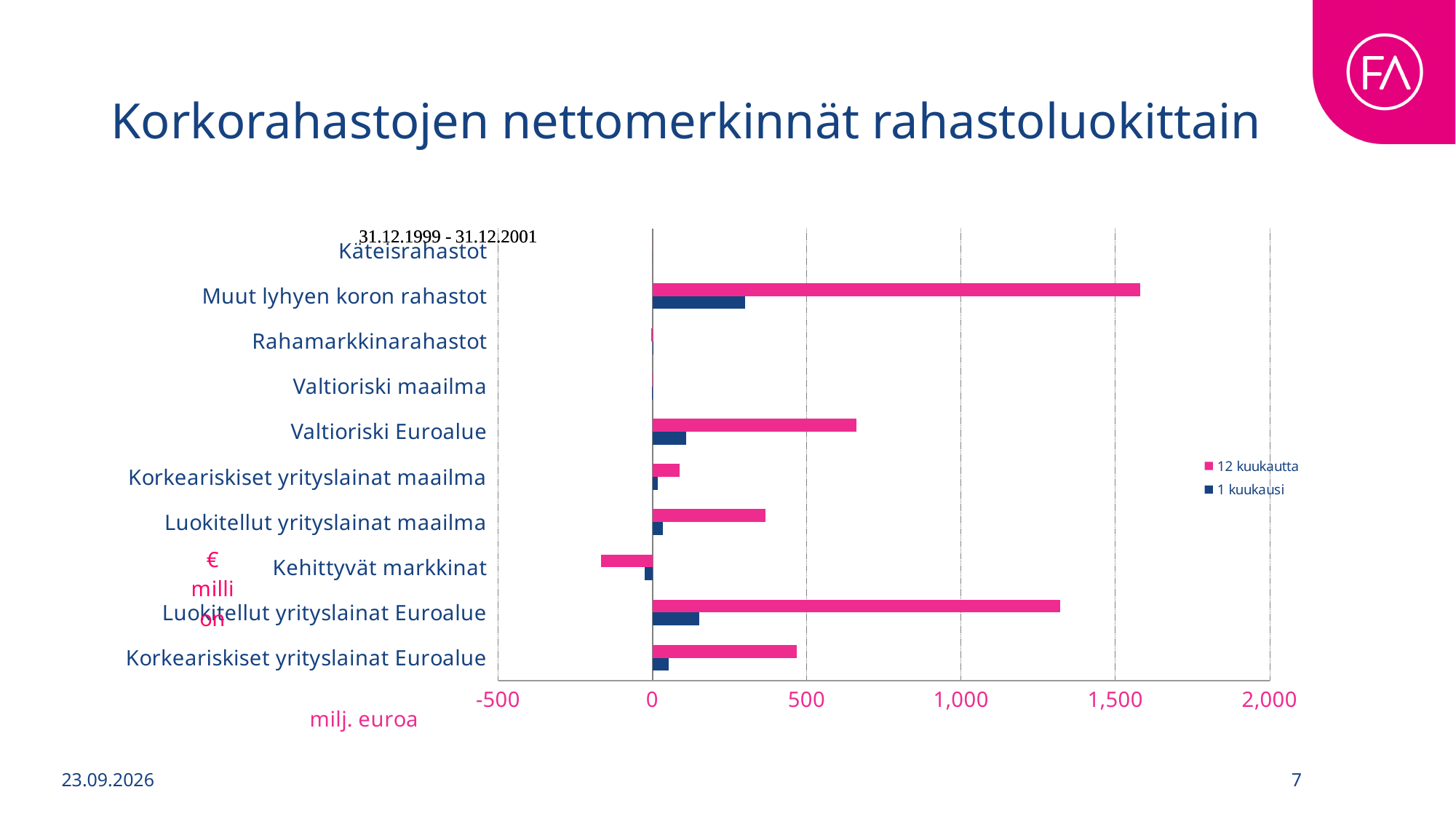
What kind of chart is shown on the slide? bar chart Which category has the highest value for the 12 kuukautta series? Muut lyhyen koron rahastot Which category has the lowest value for the 12 kuukautta series? Kehittyvät markkinat For the 12 kuukautta series, which is larger: Luokitellut yrityslainat Euroalue or Valtioriski Euroalue? Luokitellut yrityslainat Euroalue Is the 12 kuukautta value for Muut lyhyen koron rahastot greater or less than 1,500? greater Is the 1 kuukausi value for Muut lyhyen koron rahastot greater or less than 500? less Is the 12 kuukautta value for Valtioriski Euroalue greater or less than 500? greater How many series does the legend list? 2 How many fund categories are listed on the vertical axis of the chart? 10 Which series is shown in pink in the chart? 12 kuukautta